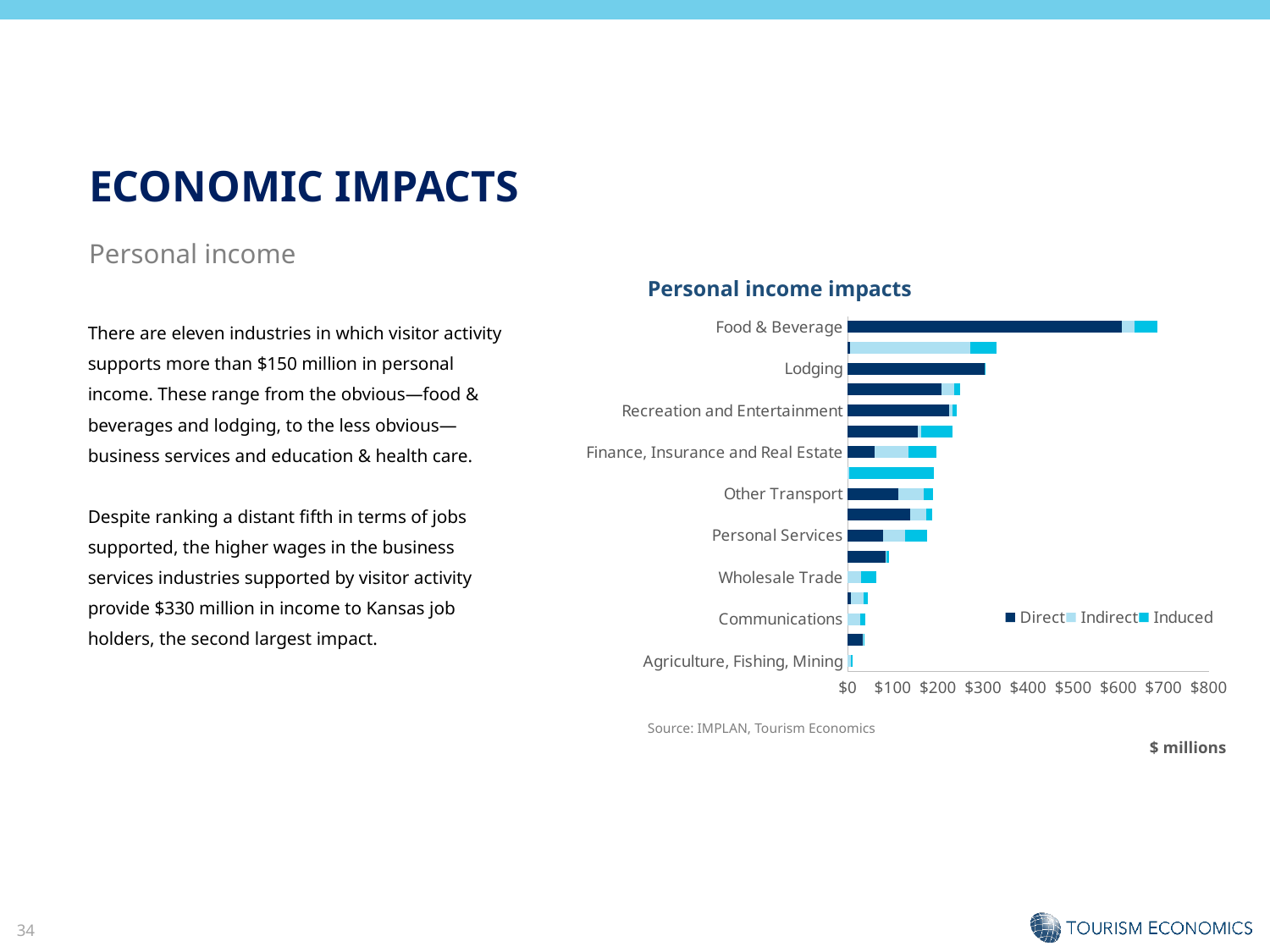
Which has a larger total personal income impact, Food & Beverage or Lodging? Food & Beverage Is the total value for Communications greater or less than $100? less Is the total value for Lodging greater or less than $200? greater Is the total value for Wholesale Trade greater or less than $100? less Which labeled industry has the largest total personal income impact? Food & Beverage Which labeled industry has the smallest total personal income impact? Agriculture, Fishing, Mining What kind of chart is shown on the slide? bar chart How many series does the chart legend list? 3 What are the three series named in the legend? Direct, Indirect, Induced Which has a larger total personal income impact, Recreation and Entertainment or Wholesale Trade? Recreation and Entertainment What is the title of the chart? Personal income impacts